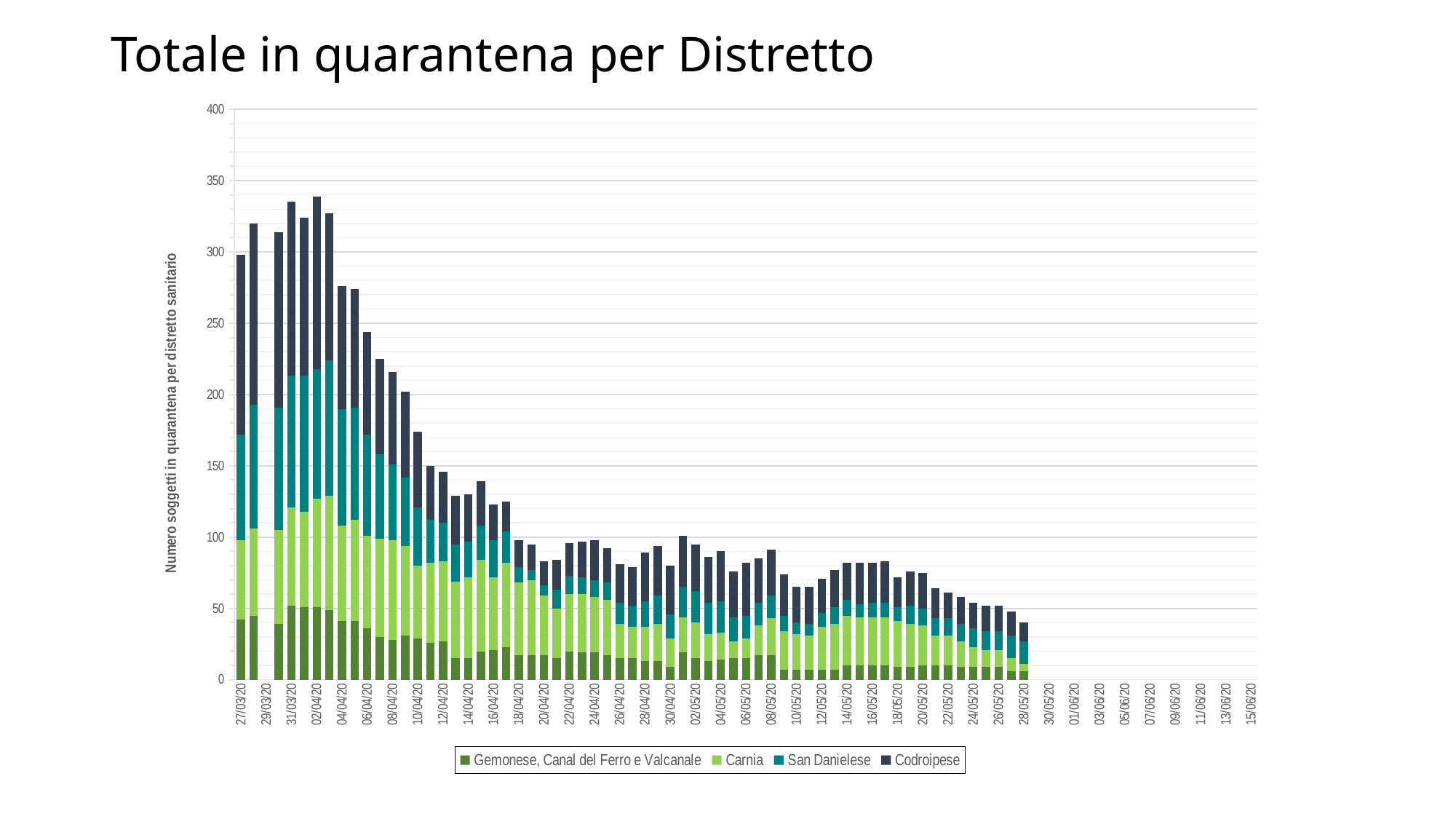
How many series does the legend list? 4 Which series is shown at the bottom of each stacked bar? Gemonese, Canal del Ferro e Valcanale Is the total value for 10/04/20 greater or less than 150? greater Is the total value for 27/03/20 greater or less than 250? greater Is the total value for 28/05/20 greater or less than 50? less What kind of chart is shown on the slide? Stacked bar chart Which series contributes the most to the bar for 27/03/20? Codroipese Do the total values generally rise or fall from left to right along the x axis? fall What is the title of the chart? Totale in quarantena per Distretto Which has the larger total, 02/04/20 or 04/04/20? 02/04/20